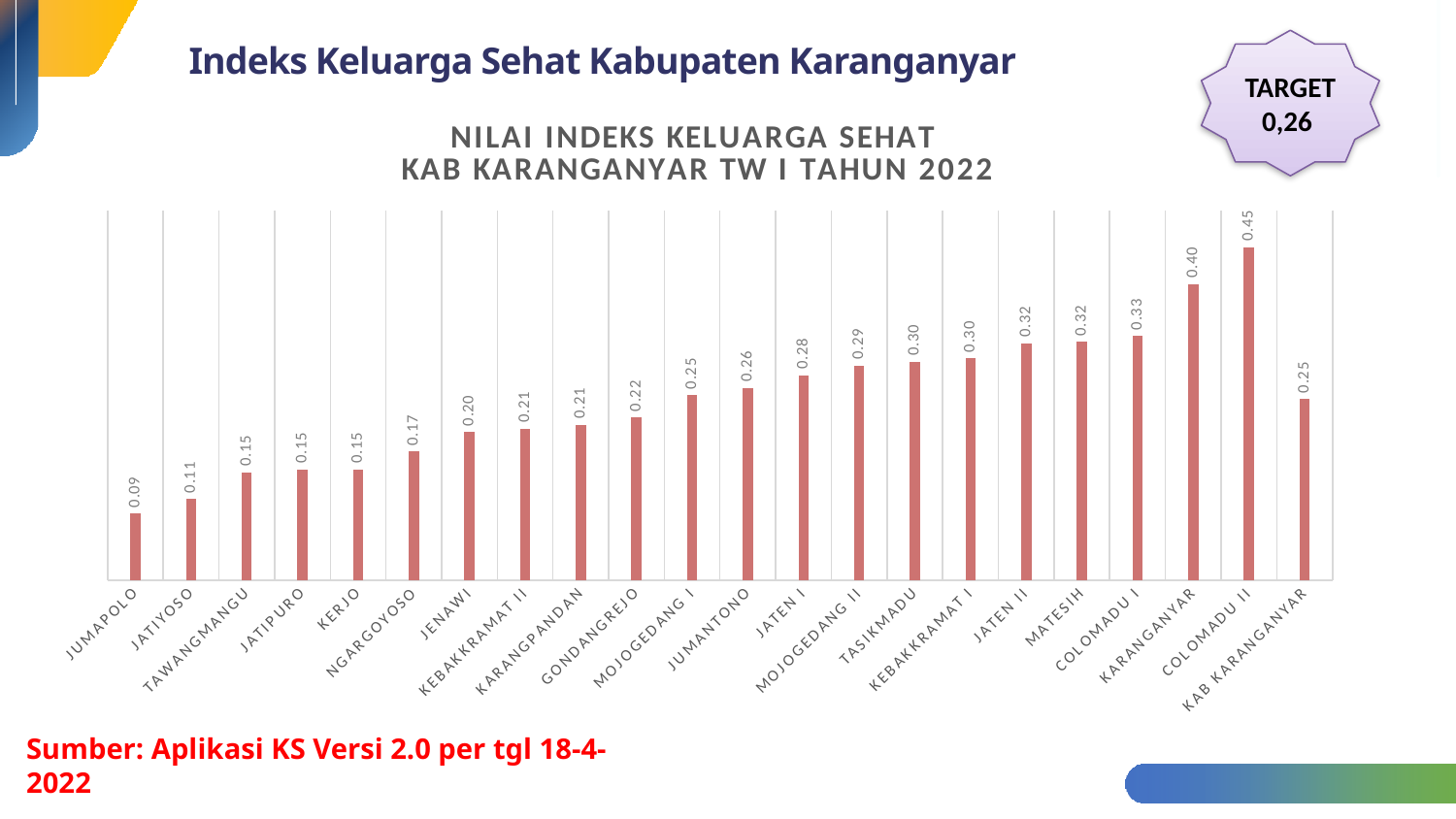
What is the value for NGARGOYOSO? 0.17 What is the value for COLOMADU I? 0.33 What kind of chart is shown on the slide? Bar chart What target value is shown in the badge at the top right of the slide? 0,26 What is the difference between the values for JATEN I and JUMAPOLO? 0.19 Which category has the lowest value? JUMAPOLO How many bars are shown in the chart? 22 What is the value for KAB KARANGANYAR? 0.25 Which category has the highest value? COLOMADU II Which is larger, the value for TASIKMADU or the value for GONDANGREJO? TASIKMADU What is the difference between the values for COLOMADU II and KARANGANYAR? 0.05 What is the value for JUMAPOLO? 0.09